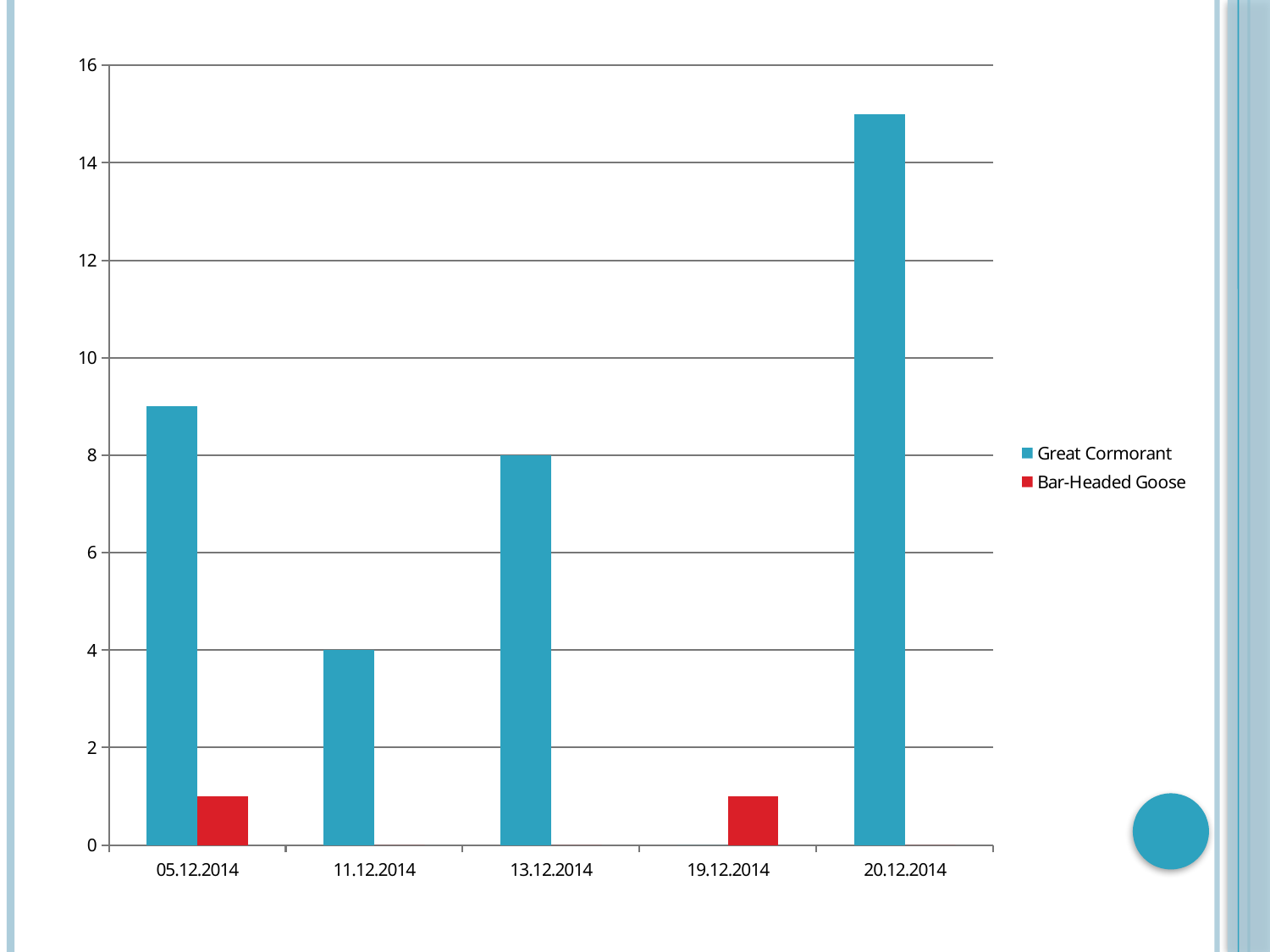
What is the Great Cormorant value for 11.12.2014? 4 Is the Bar-Headed Goose value for 05.12.2014 greater or less than 2? less How many series does the legend list? 2 How many dates are shown on the x axis? 5 What is the Great Cormorant value for 13.12.2014? 8 Is the Great Cormorant value for 20.12.2014 greater or less than 14? greater What type of chart is shown on the slide? bar chart On which date is the Great Cormorant value highest? 20.12.2014 Which is larger, the Great Cormorant value for 05.12.2014 or for 11.12.2014? 05.12.2014 Is the Great Cormorant value for 05.12.2014 greater or less than 8? greater What is the difference between the Great Cormorant values for 13.12.2014 and 11.12.2014? 4 On which date is the Great Cormorant value lowest? 19.12.2014